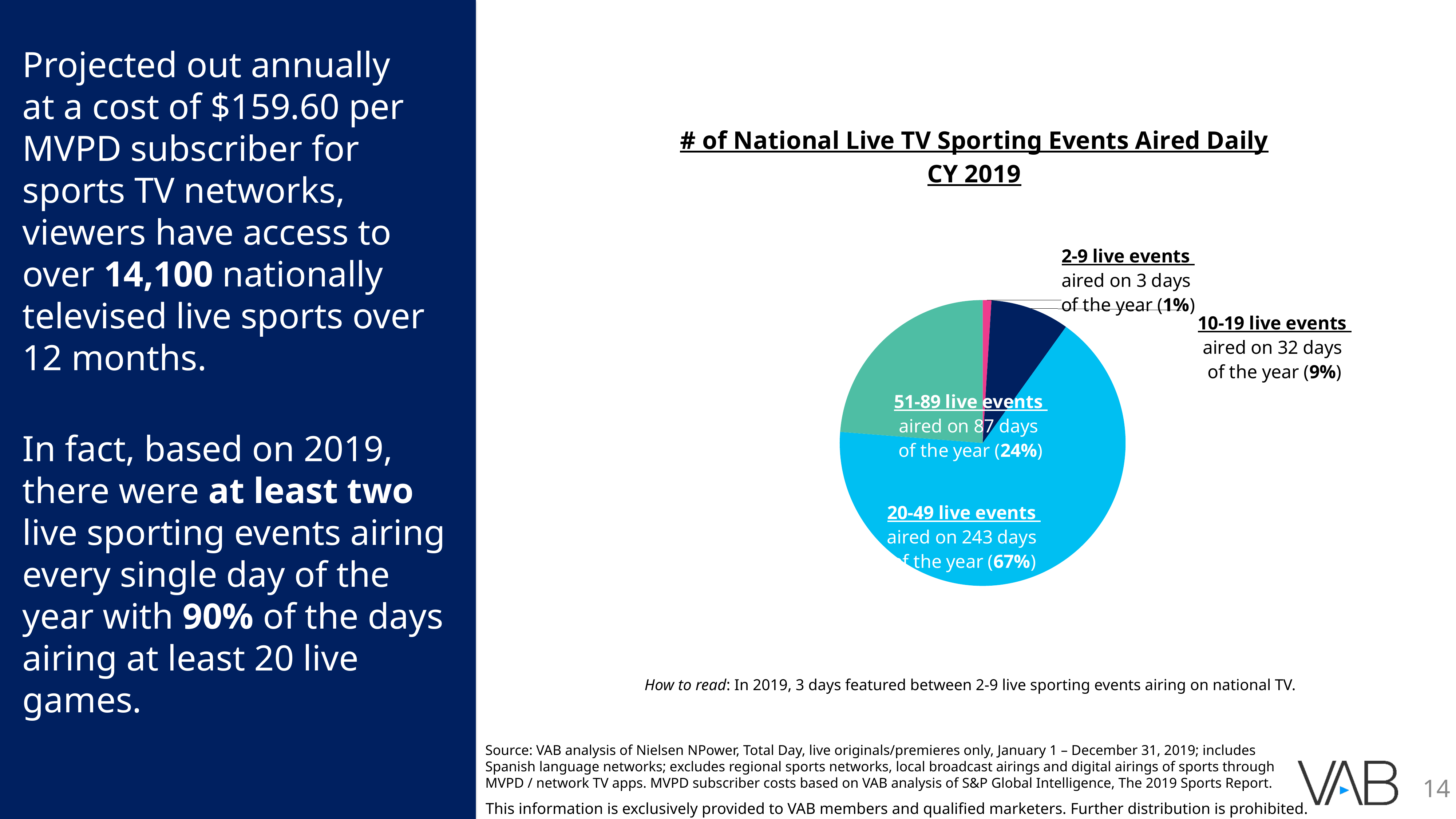
What share of the year had 2-9 live events aired? 1% What kind of chart is shown on the slide? pie chart Which category accounts for the largest share of days? 20-49 live events How many slices does the pie chart have? 4 On how many days of the year did 20-49 live events air? 243 days What is the difference in percentage share between 10-19 live events and 2-9 live events? 8% On how many days of the year did 10-19 live events air? 32 days Which had more days: 10-19 live events or 51-89 live events? 51-89 live events What share of the year had 51-89 live events aired? 24% What is the title of the chart? # of National Live TV Sporting Events Aired Daily CY 2019 Which category accounts for the smallest share of days? 2-9 live events How many more days had 20-49 live events than 51-89 live events? 156 days